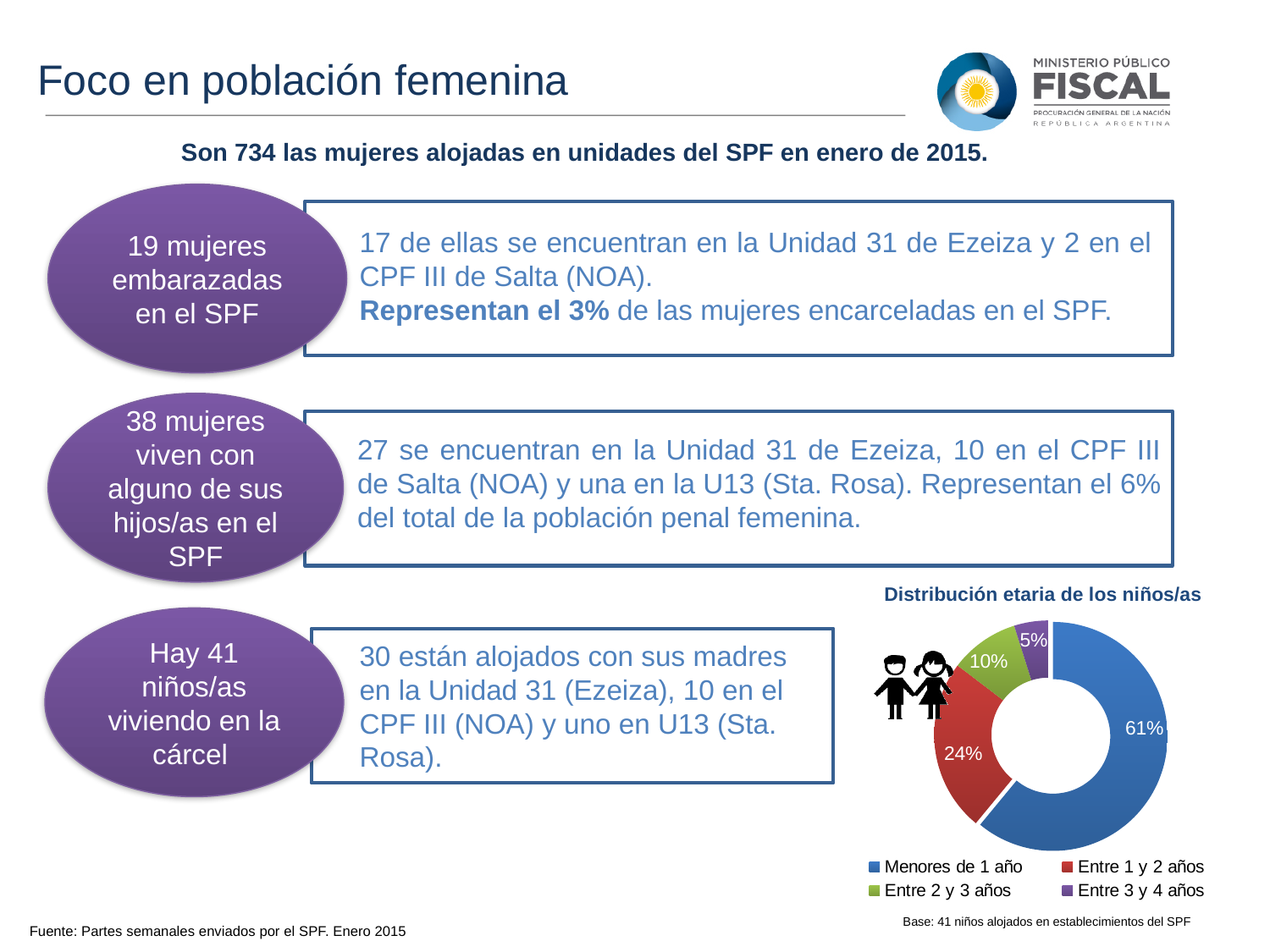
What is the difference in percentage points between 'Menores de 1 año' and 'Entre 1 y 2 años'? 37 What share of the children are 'Entre 2 y 3 años'? 10% Which is larger: the share for 'Entre 2 y 3 años' or 'Entre 3 y 4 años'? Entre 2 y 3 años Which age group has the largest share of the children? Menores de 1 año What kind of chart is 'Distribución etaria de los niños/as'? Pie chart (doughnut) What share of the children are 'Menores de 1 año'? 61% What is the base (number of children) stated below the chart? 41 niños alojados en establecimientos del SPF What share of the children are 'Entre 3 y 4 años'? 5% What share of the children are 'Entre 1 y 2 años'? 24% What is the title of the chart? Distribución etaria de los niños/as Which age group has the smallest share of the children? Entre 3 y 4 años How many age groups does the chart show? 4